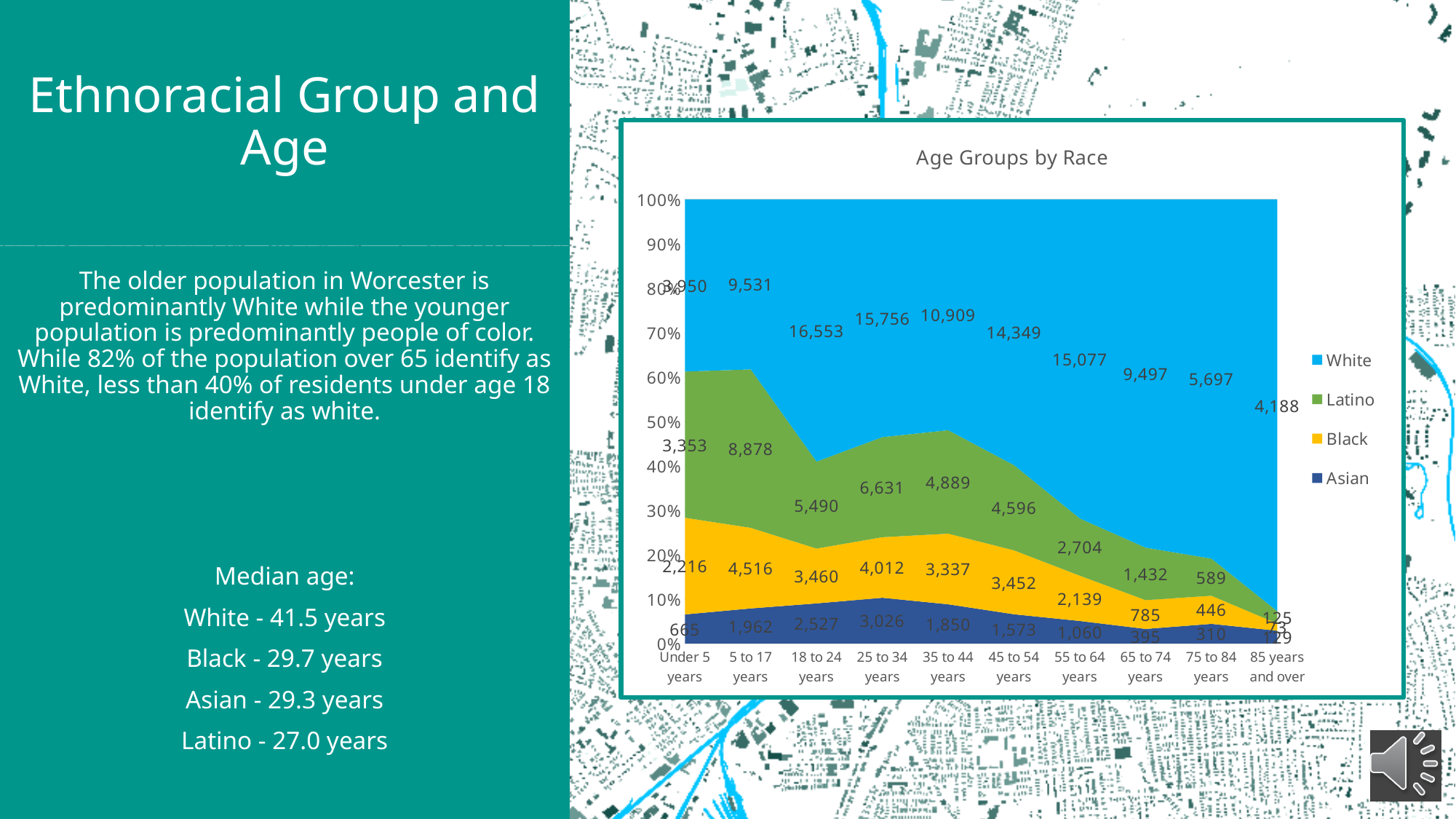
What is the Latino value for the 5 to 17 years age group? 8,878 What is the White value for the 18 to 24 years age group? 16,553 What is the Black value for the 45 to 54 years age group? 3,452 What is the Asian value for the 25 to 34 years age group? 3,026 What kind of chart is shown on the slide? Stacked area chart How many age group categories are shown on the x axis of the chart? 10 Which is larger, the Black value for 5 to 17 years or the Black value for 25 to 34 years? 5 to 17 years Which age group has the lowest Asian value? 85 years and over How many series does the chart legend list? 4 What is the title of the chart on the slide? Age Groups by Race What is the difference between the Latino values for 25 to 34 years and 35 to 44 years? 1,742 Which age group has the highest White value? 18 to 24 years